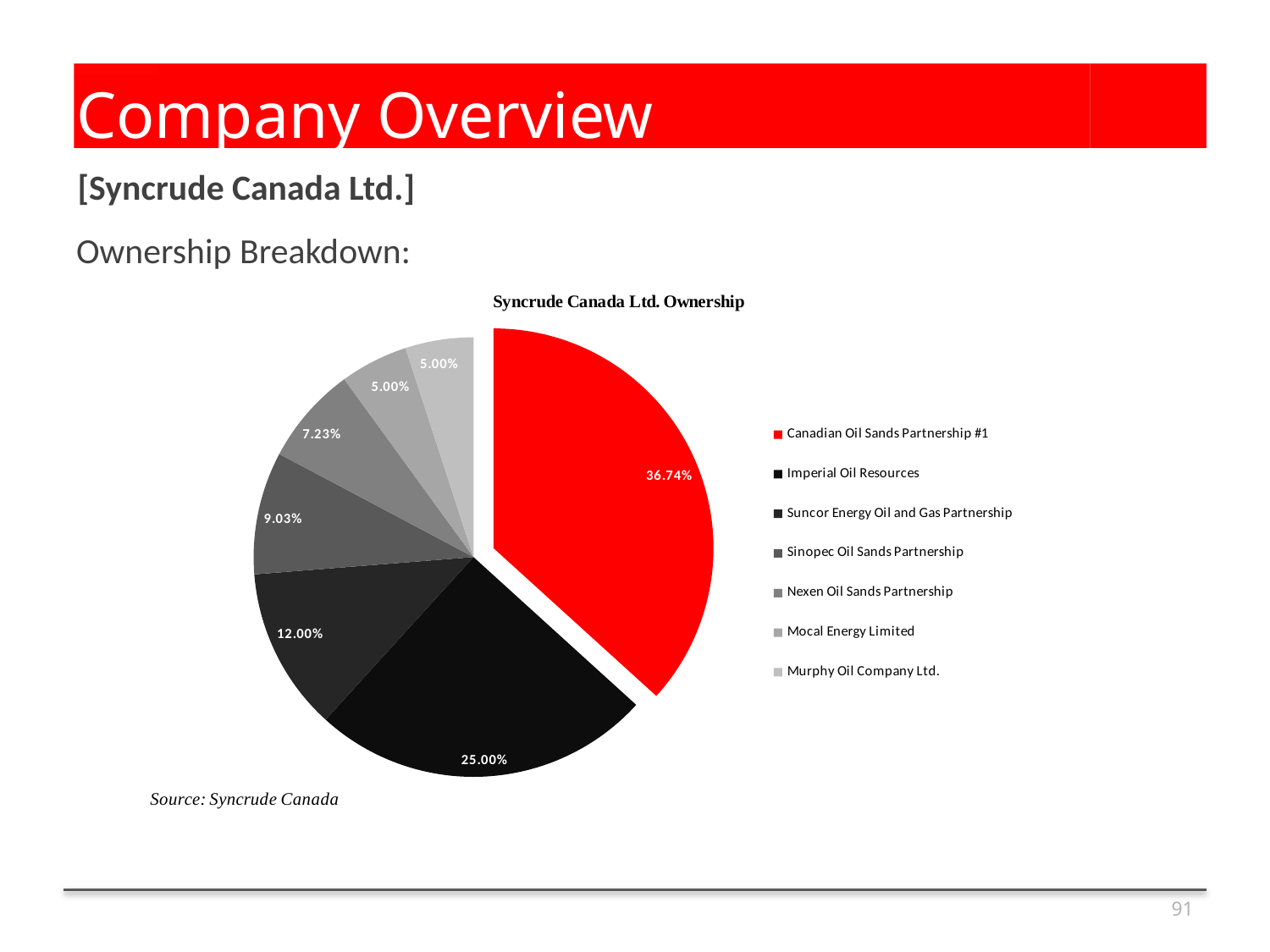
What is the smallest ownership share shown in the pie chart? 5.00% What share of ownership does Canadian Oil Sands Partnership #1 hold? 36.74% What share of ownership does Sinopec Oil Sands Partnership hold? 9.03% What type of chart is shown on the slide? pie chart What share of ownership does Suncor Energy Oil and Gas Partnership hold? 12.00% What share of ownership does Imperial Oil Resources hold? 25.00% Which holds a larger share, Sinopec Oil Sands Partnership or Nexen Oil Sands Partnership? Sinopec Oil Sands Partnership How many owners are listed in the chart legend? 7 What is the title of the chart? Syncrude Canada Ltd. Ownership Which owner holds the largest share of Syncrude Canada Ltd.? Canadian Oil Sands Partnership #1 What is the difference between the shares of Canadian Oil Sands Partnership #1 and Imperial Oil Resources? 11.74% What share of ownership does Nexen Oil Sands Partnership hold? 7.23%